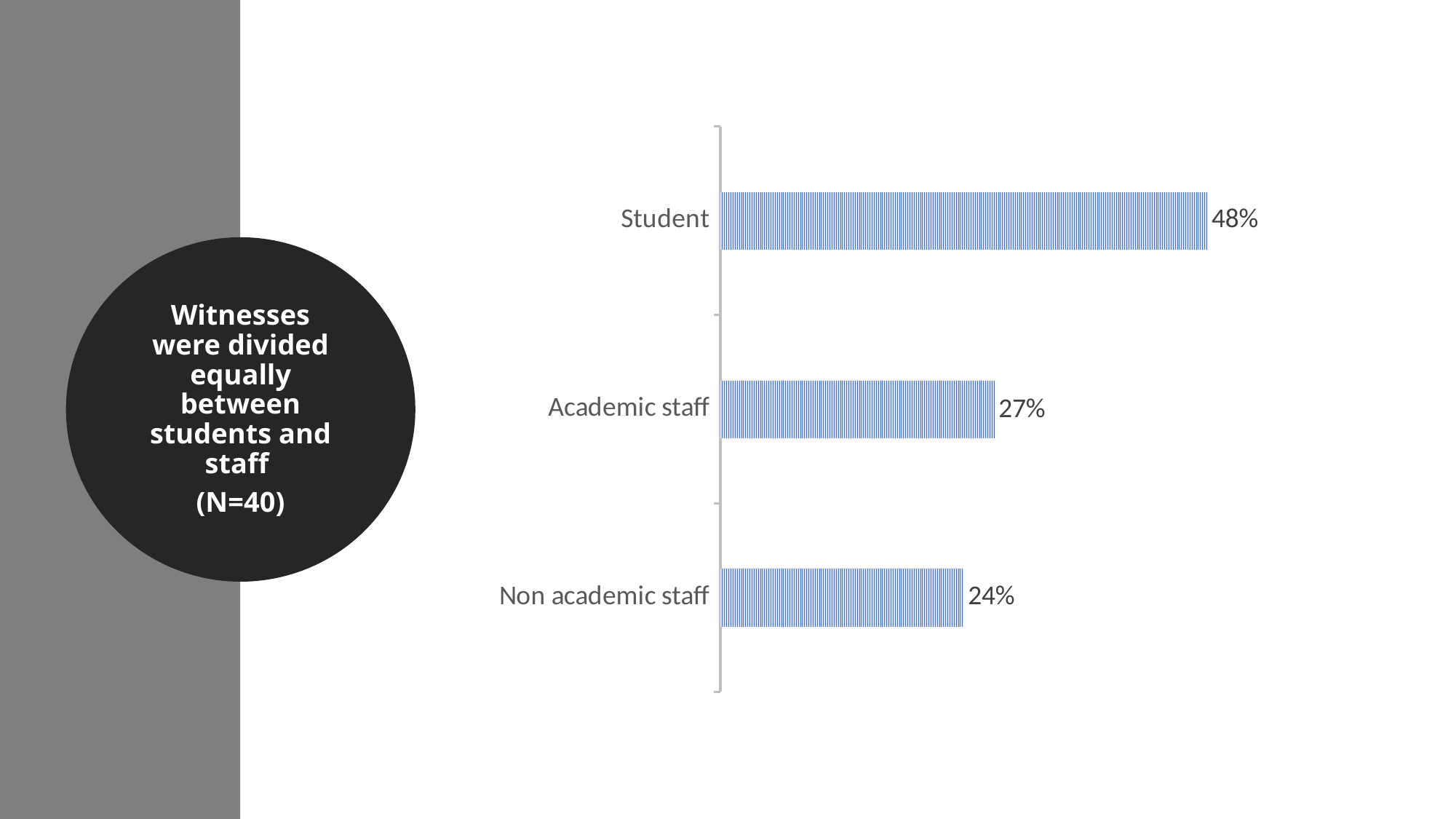
What is the difference between the values for Academic staff and Non academic staff? 3% Which is larger, the value for Student or the value for Non academic staff? Student What is the total of the values for Academic staff and Non academic staff? 51% What is the value for Academic staff? 27% What kind of chart is shown on the slide? Bar chart Which category has the highest value? Student What is the value for Student? 48% How many categories are shown in the chart? 3 What is the sample size stated in the circle on the slide? N=40 What is the difference between the values for Student and Academic staff? 21% What is the value for Non academic staff? 24% Which category has the lowest value? Non academic staff